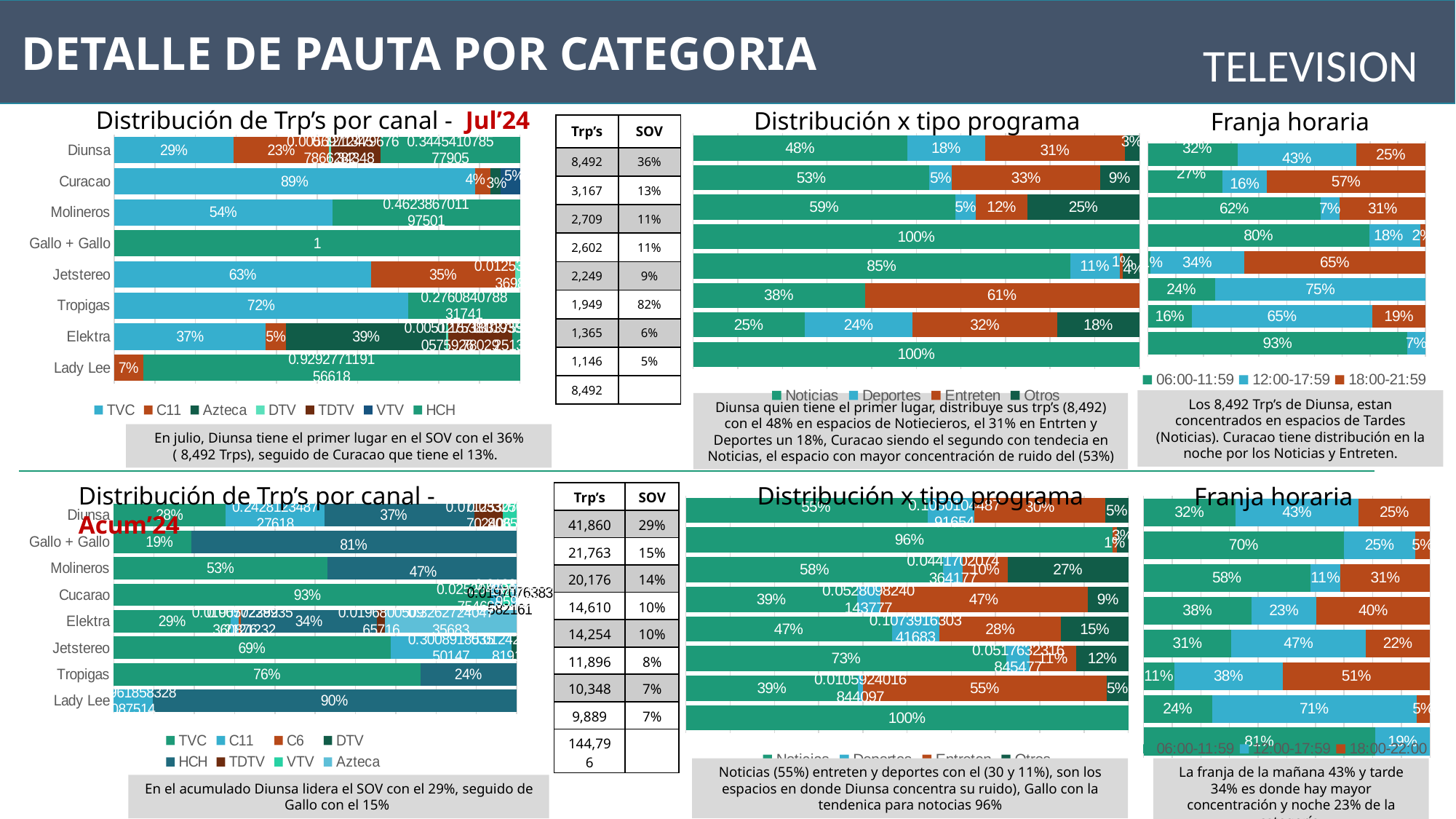
In the bottom-left chart 'Distribución de Trp's por canal - Acum'24', which is larger for Molineros, the TVC share or the HCH share? TVC How many channels are shown in the top-left chart 'Distribución de Trp's por canal - Jul'24'? 8 How many series does the legend of the top-left chart 'Distribución de Trp's por canal - Jul'24' list? 7 In the top-left chart 'Distribución de Trp's por canal - Jul'24', what is the C11 share for Jetstereo? 35% What kind of chart is the top-left 'Distribución de Trp's por canal - Jul'24'? Stacked bar chart In the top-left chart 'Distribución de Trp's por canal - Jul'24', what is the TVC share for Curacao? 89% In the top-right 'Franja horaria' chart, what is the 18:00-21:59 share in the second bar from the top? 57% How many time bands does the legend of the top-right 'Franja horaria' chart list? 3 In the top 'Distribución x tipo programa' chart, what is the Noticias share in the first bar from the top? 48% In the top 'Distribución x tipo programa' chart, what is the difference between the Entreten (31%) and Deportes (18%) shares in the first bar from the top? 13 percentage points In the top-left chart 'Distribución de Trp's por canal - Jul'24', which channel has the highest TVC share? Curacao In the bottom-left chart 'Distribución de Trp's por canal - Acum'24', what is the HCH share for Lady Lee? 90%